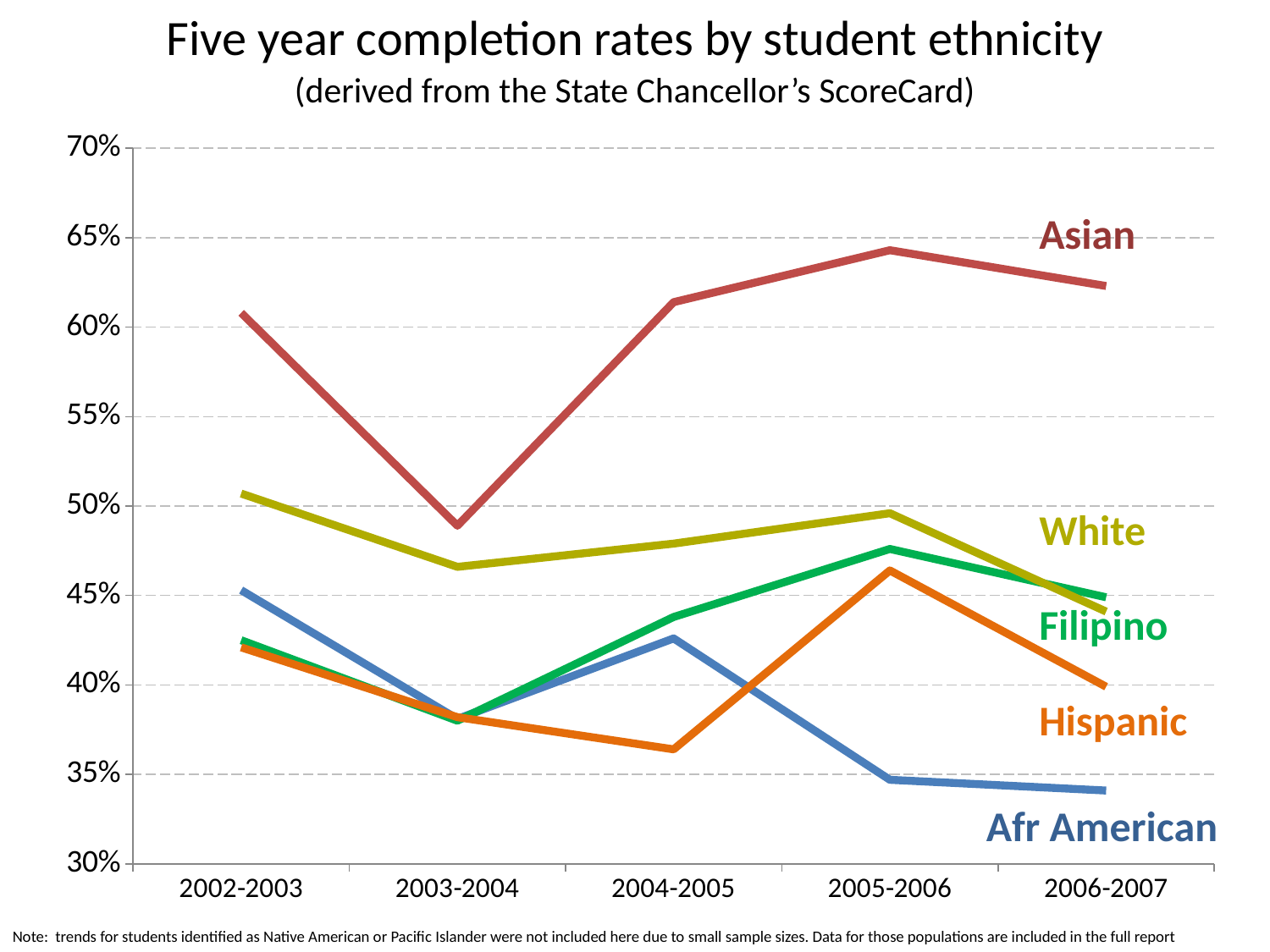
How many academic years are plotted along the x axis? 5 Is the White completion rate in 2003-2004 greater or less than 50%? less In which year is the Asian completion rate at its lowest? 2003-2004 Which ethnicity has the lowest five year completion rate in 2006-2007? Afr American What kind of chart is shown on the slide? line chart Is the Asian completion rate in 2005-2006 greater or less than 60%? greater How many student ethnicity series are plotted on the chart? 5 Does the Asian completion rate rise or fall from 2003-2004 to 2005-2006? rise In which year is the Hispanic completion rate at its highest? 2005-2006 Which ethnicity has the highest five year completion rate in 2006-2007? Asian In 2002-2003, which is larger, the Asian or the White completion rate? Asian Is the Afr American completion rate in 2006-2007 greater or less than 35%? less